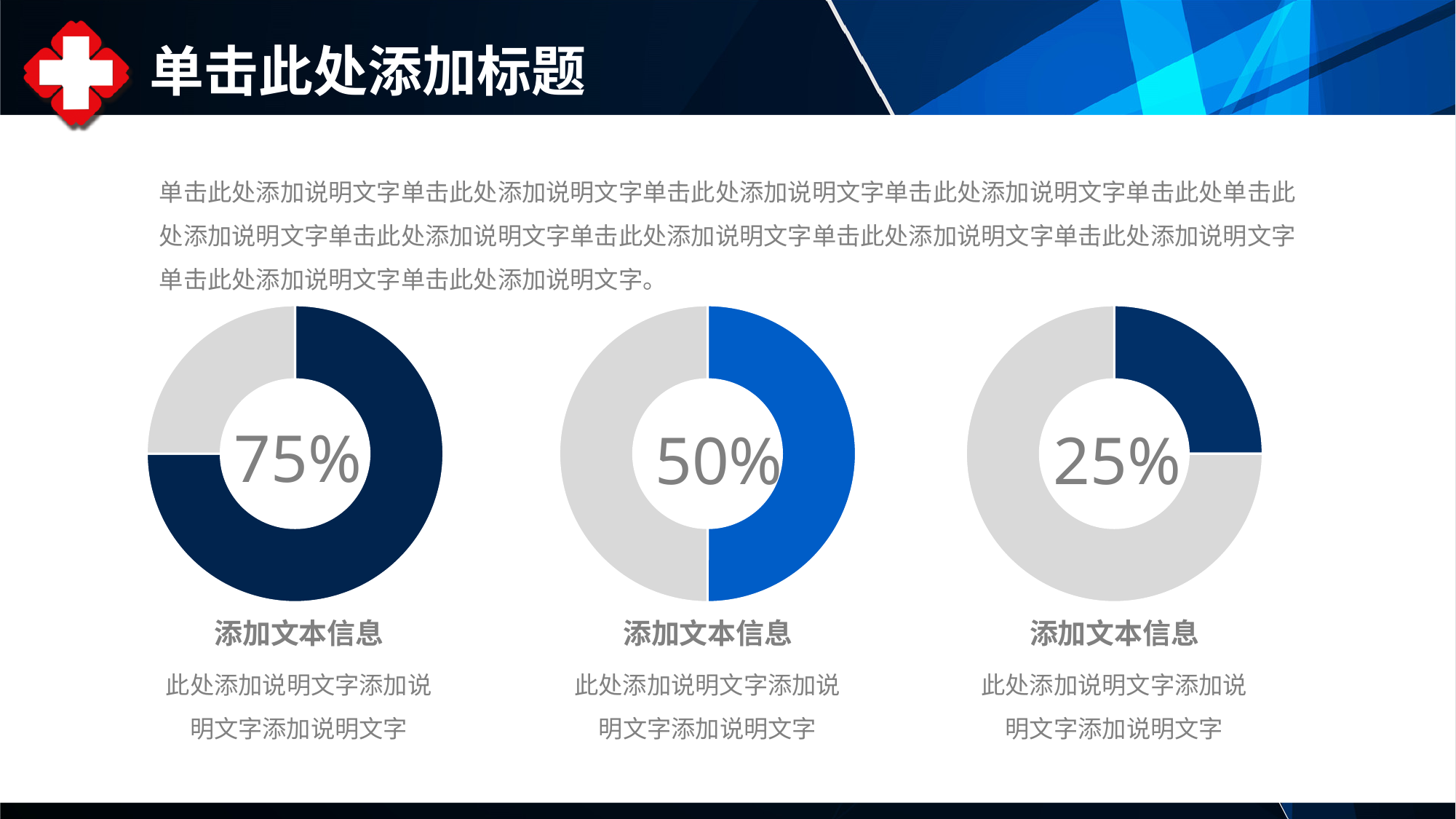
Do the percentages in the donut charts rise or fall from left to right across the slide? fall Which of the three donut charts shows the highest percentage: left, middle or right? left What is the difference between the percentage in the middle donut chart and the percentage in the right donut chart? 25% What percentage is shown in the centre of the right donut chart? 25% Which of the three donut charts shows the lowest percentage: left, middle or right? right How many donut charts are on the slide? 3 What percentage is shown in the centre of the middle donut chart? 50% What is the difference between the percentage in the left donut chart and the percentage in the right donut chart? 50% What percentage is shown in the centre of the left donut chart? 75% What kind of chart is used for the three figures on the slide? donut chart Is the percentage in the middle donut chart larger or smaller than the percentage in the left donut chart? smaller What colour is the filled portion of the middle donut chart? blue